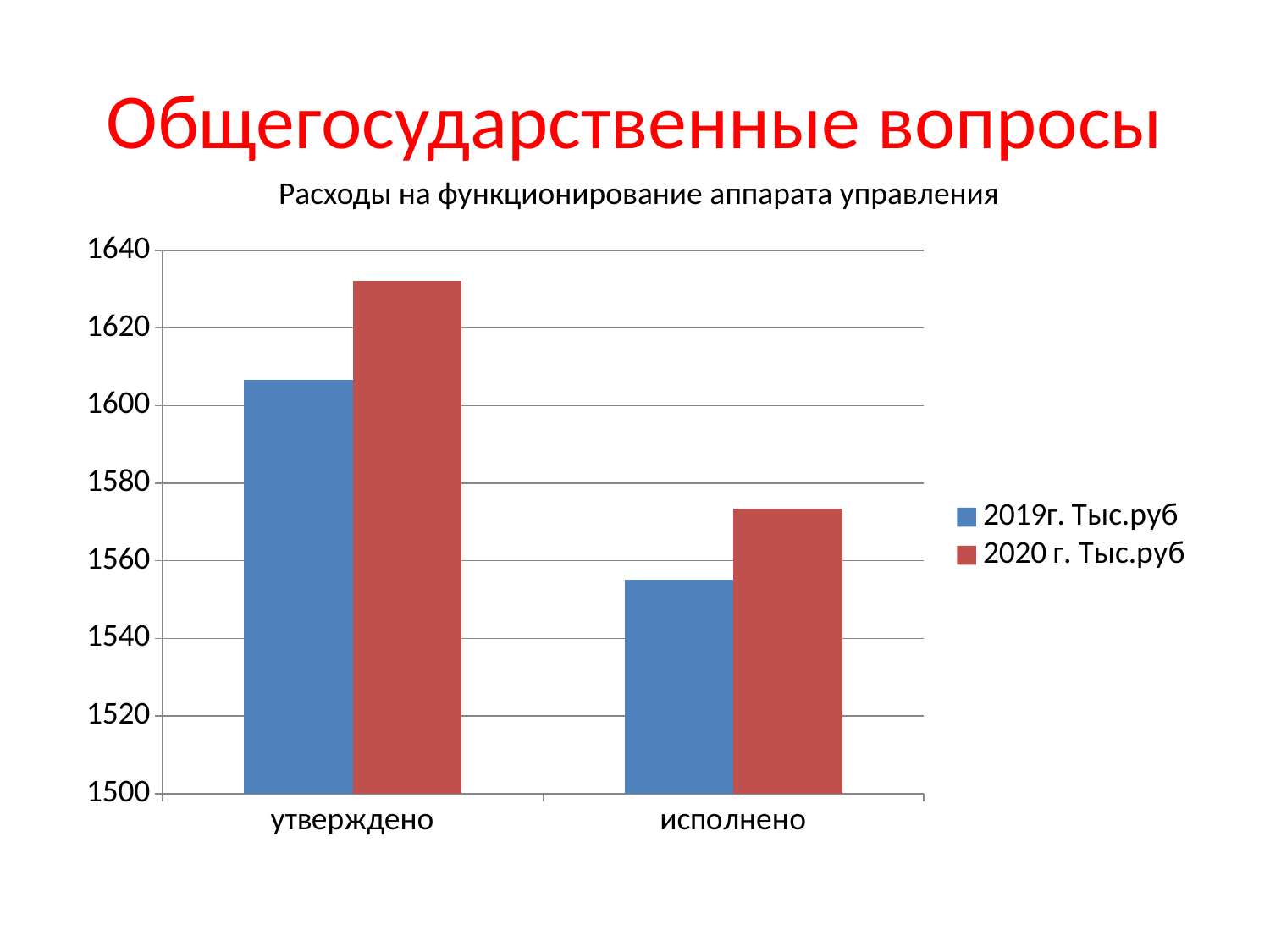
Is the value for утверждено in the 2019г. Тыс.руб series greater or less than 1600? greater Which series is shown in red? 2020 г. Тыс.руб What kind of chart is shown on the slide? bar chart Which category has the highest value in the 2020 г. Тыс.руб series? утверждено Which category has the lowest value in the 2019г. Тыс.руб series? исполнено What is the title of the chart? Расходы на функционирование аппарата управления Is the value for утверждено in the 2020 г. Тыс.руб series greater or less than 1620? greater Is the value for исполнено in the 2020 г. Тыс.руб series greater or less than 1580? less How many categories are shown on the x axis? 2 Which is larger for утверждено: the 2019г. Тыс.руб value or the 2020 г. Тыс.руб value? 2020 г. Тыс.руб How many series does the legend list? 2